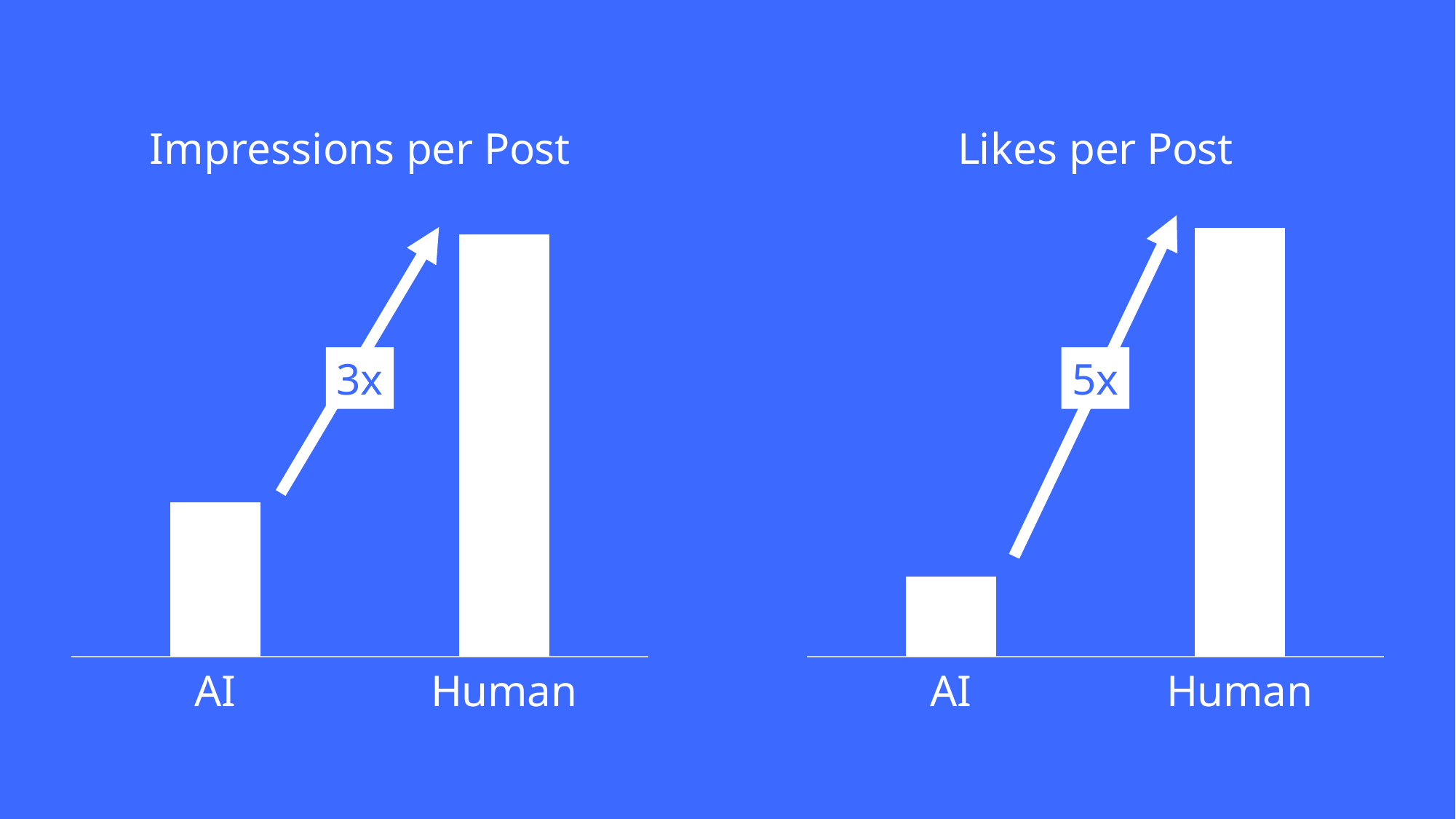
In the "Impressions per Post" chart, which category has the higher bar? Human In the "Impressions per Post" chart, is the bar for Human larger or smaller than the bar for AI? larger What kind of chart is the "Impressions per Post" chart? bar chart In the "Likes per Post" chart, which category has the higher bar? Human In the "Likes per Post" chart, is the bar for AI larger or smaller than the bar for Human? smaller What kind of chart is the "Likes per Post" chart? bar chart How many categories are shown in the "Likes per Post" chart? 2 In the "Likes per Post" chart, which category has the lower bar? AI How many categories are shown in the "Impressions per Post" chart? 2 In the "Impressions per Post" chart, what multiplier is labelled on the arrow from AI to Human? 3x In the "Impressions per Post" chart, which category has the lower bar? AI In the "Likes per Post" chart, what multiplier is labelled on the arrow from AI to Human? 5x